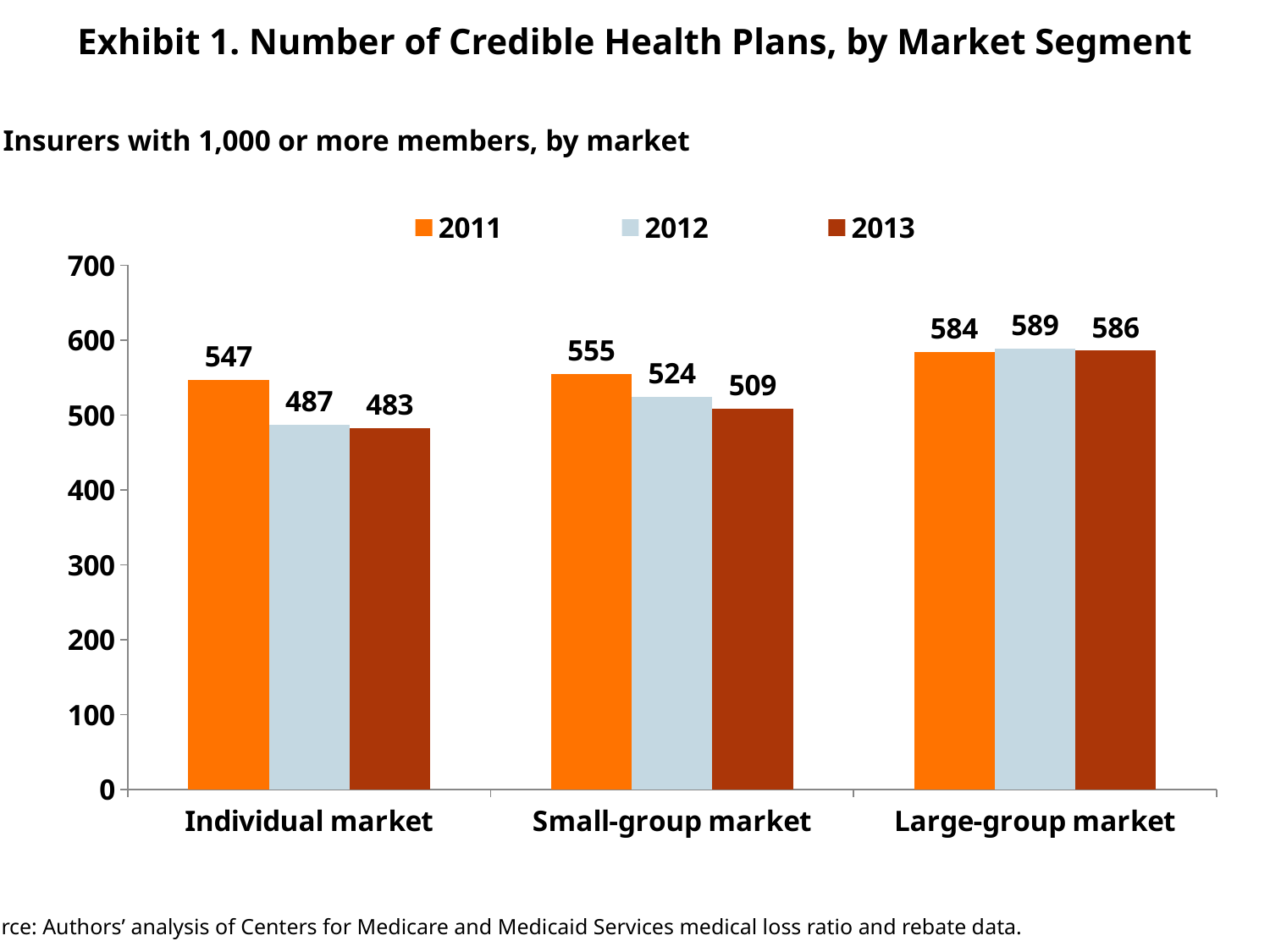
What is the value for the Small-group market in 2013? 509 Which market segment has the lowest value in 2013? Individual market Which market segment has the highest value in 2011? Large-group market What is the difference between the 2011 and 2013 values for the Individual market? 64 Which is larger: the 2012 value for the Individual market or the 2012 value for the Small-group market? Small-group market Do the values for the Small-group market rise or fall from 2011 to 2013? Fall What kind of chart is shown on the slide? Bar chart What is the number of credible health plans in the Individual market in 2011? 547 How many market segments are shown on the x axis? 3 What is the difference between the 2011 and 2012 values for the Small-group market? 31 What is the value for the Large-group market in 2012? 589 How many series does the legend list? 3